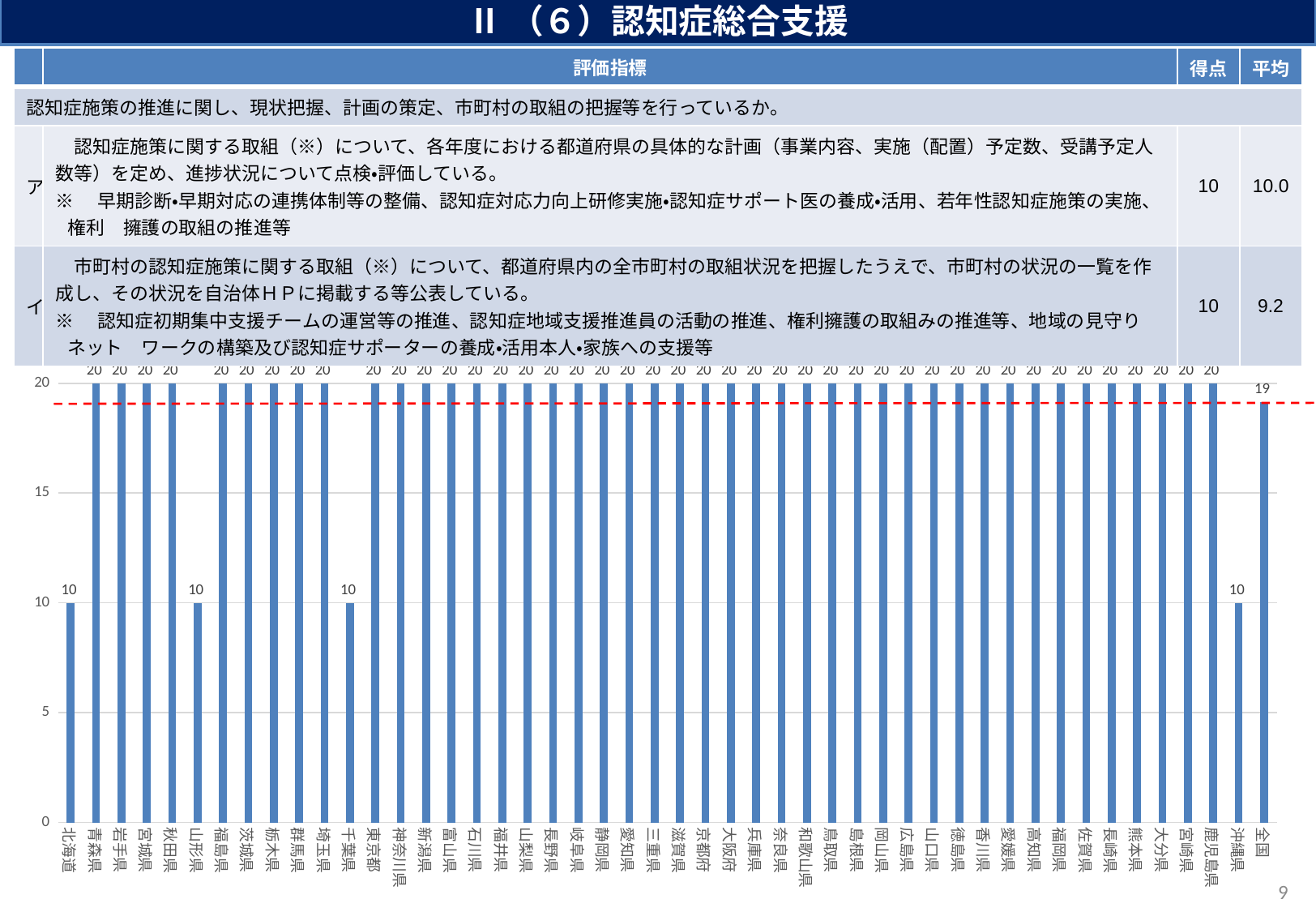
What kind of chart is shown on the slide? bar chart What is the value for 千葉県? 10 Is the value for 全国 greater or less than 15? greater How many bars have a value of 10? 4 Which is larger, the value for 山形県 or the value for 福島県? 福島県 What is the value for 沖縄県? 10 What is the value for 東京都? 20 What is the difference between the value for 鹿児島県 and the value for 全国? 1 What is the value for 全国? 19 What is the difference between the value for 青森県 and the value for 北海道? 10 How many categories are plotted on the x axis? 48 What is the value for 北海道? 10